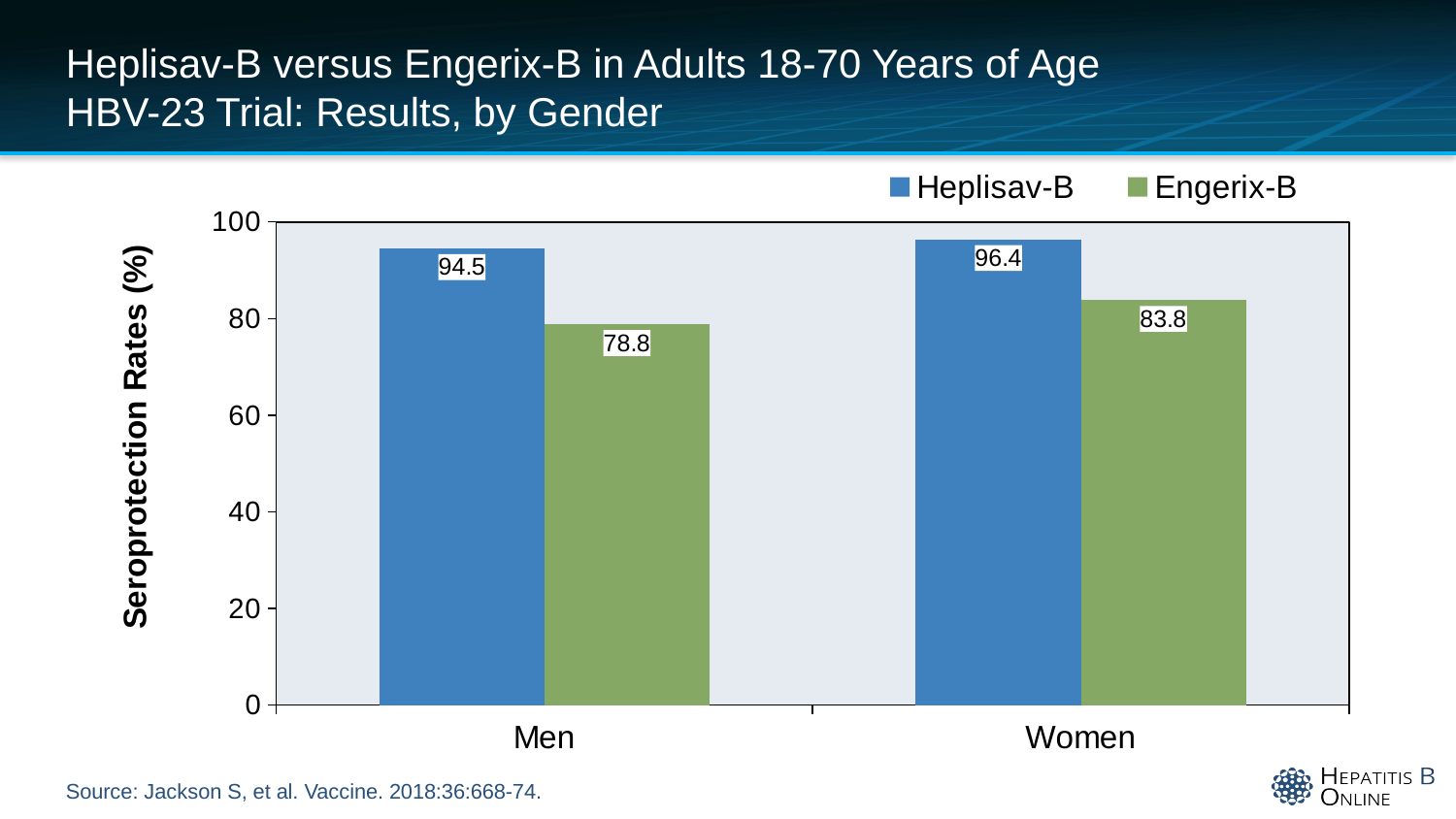
What is the difference between the Heplisav-B and Engerix-B seroprotection rates in men? 15.7 What is the seroprotection rate for Engerix-B in men? 78.8 What is the difference between the Heplisav-B and Engerix-B seroprotection rates in women? 12.6 What is the seroprotection rate for Heplisav-B in men? 94.5 What is the seroprotection rate for Engerix-B in women? 83.8 Which vaccine has the higher seroprotection rate in women, Heplisav-B or Engerix-B? Heplisav-B Which bar has the highest seroprotection rate on the chart? Heplisav-B, Women What is the seroprotection rate for Heplisav-B in women? 96.4 Which bar has the lowest seroprotection rate on the chart? Engerix-B, Men What is the label of the y axis? Seroprotection Rates (%) How many series does the legend list? 2 What kind of chart is shown on the slide? Bar chart